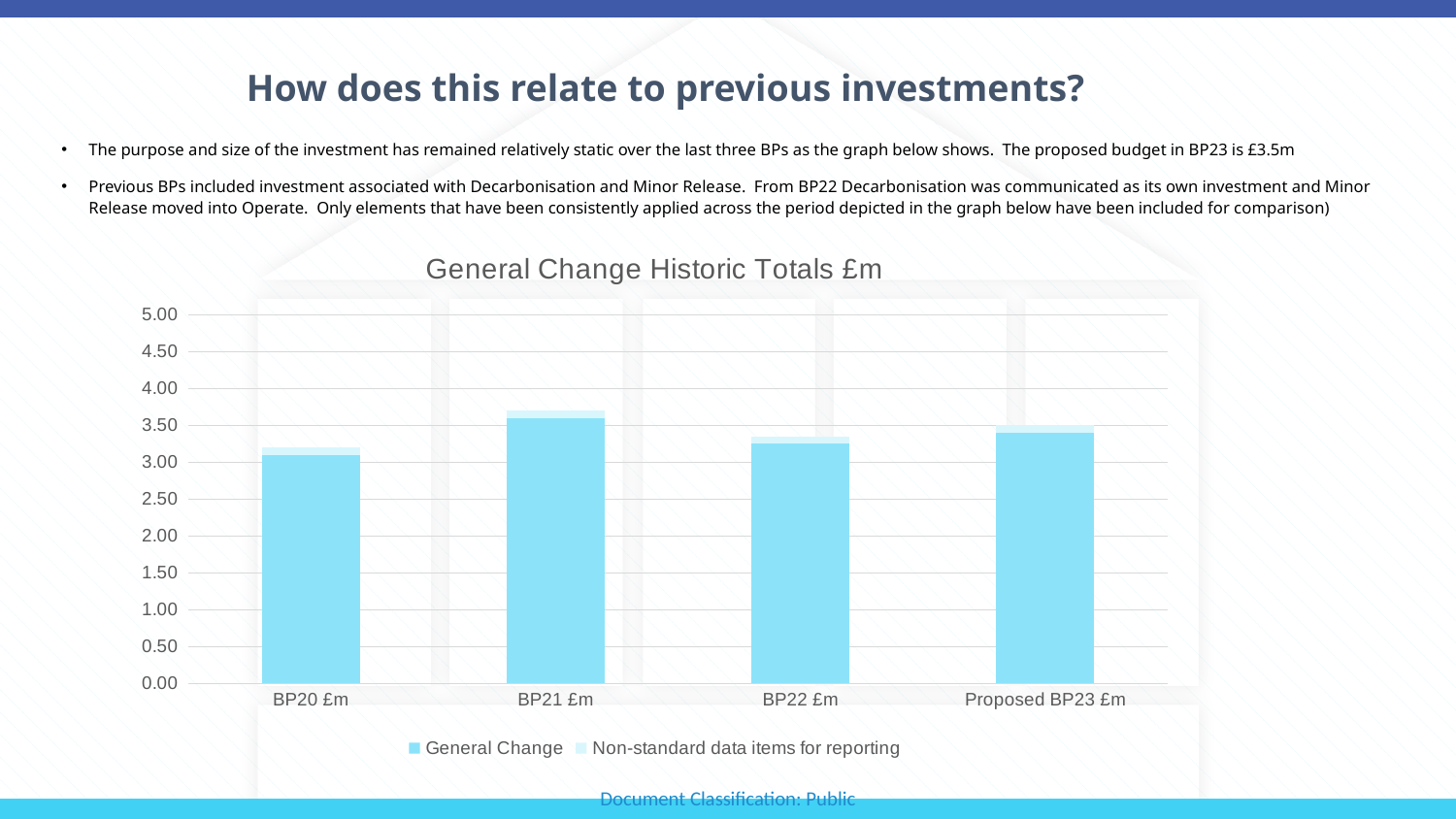
What is the title of the chart? General Change Historic Totals £m Which category has the highest total bar in the chart? BP21 £m Is the total bar for BP21 £m greater or less than 3.50? greater Is the total bar for BP22 £m greater or less than 3.00? greater Is the total bar for Proposed BP23 £m greater or less than 4.00? less How many categories are shown on the x axis of the chart? 4 What are the two series named in the chart's legend? General Change; Non-standard data items for reporting Which has the larger total bar, BP21 £m or BP22 £m? BP21 £m How many series does the chart's legend list? 2 Which category has the lowest total bar in the chart? BP20 £m What kind of chart is shown on the slide? Stacked bar chart